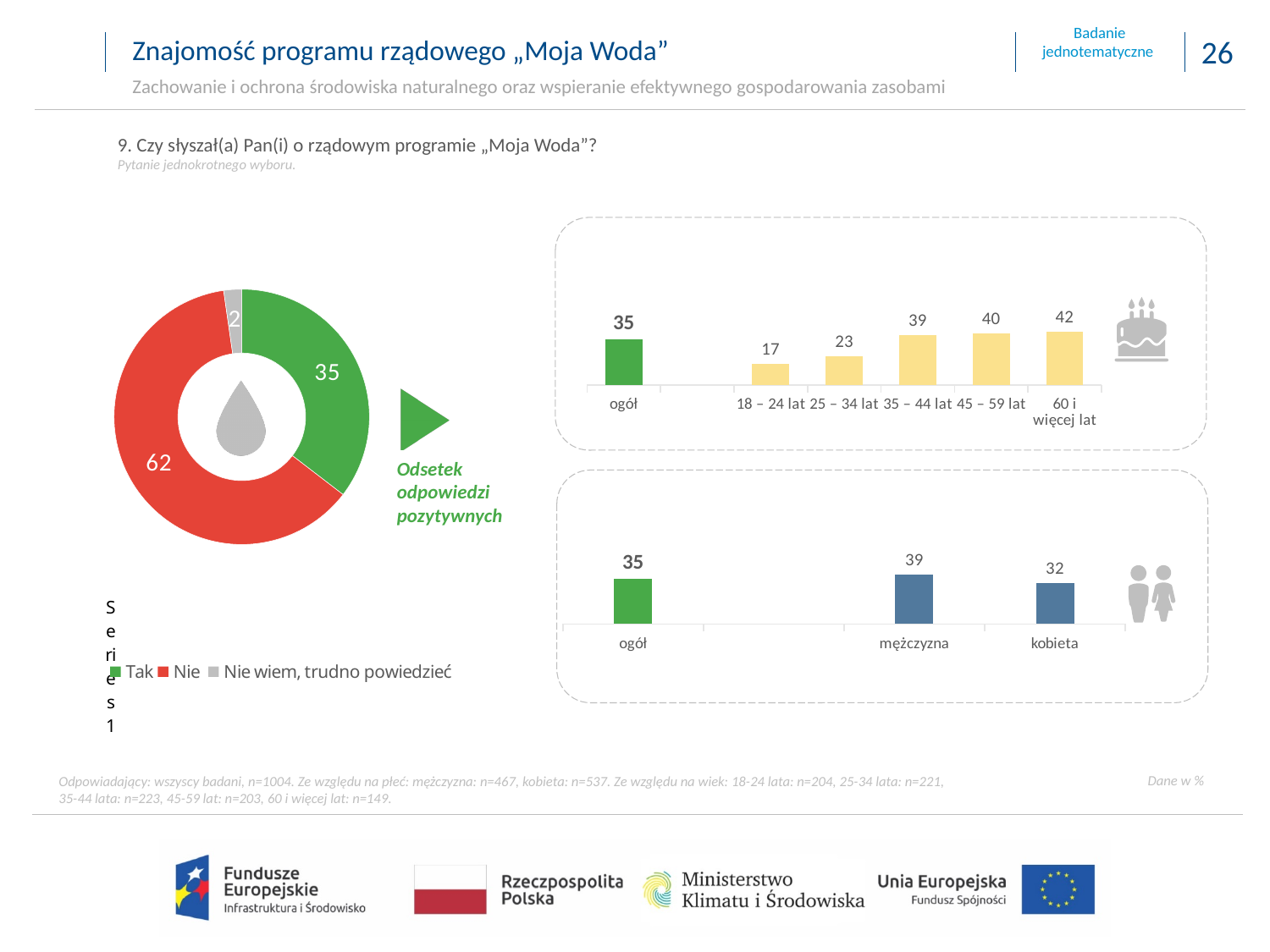
How many entries does the legend of the donut chart on the left list? 3 In the gender bar chart at the bottom right, what is the difference between "mężczyzna" and "kobieta"? 7 What kind of chart is the chart on the left of the slide? Pie (donut) chart In the age bar chart at the top right, what is the value for "18 – 24 lat"? 17 In the age bar chart at the top right, which age group has the highest value? 60 i więcej lat In the gender bar chart at the bottom right, what is the value for "mężczyzna"? 39 In the donut chart on the left, what is the value for "Nie"? 62 In the age bar chart at the top right, do the values rise or fall from the youngest to the oldest age group? Rise In the donut chart on the left, which answer has the smallest share? Nie wiem, trudno powiedzieć In the donut chart on the left, what is the value for "Tak"? 35 In the gender bar chart at the bottom right, which is larger, "mężczyzna" or "kobieta"? mężczyzna In the age bar chart at the top right, what is the difference between "60 i więcej lat" and "18 – 24 lat"? 25